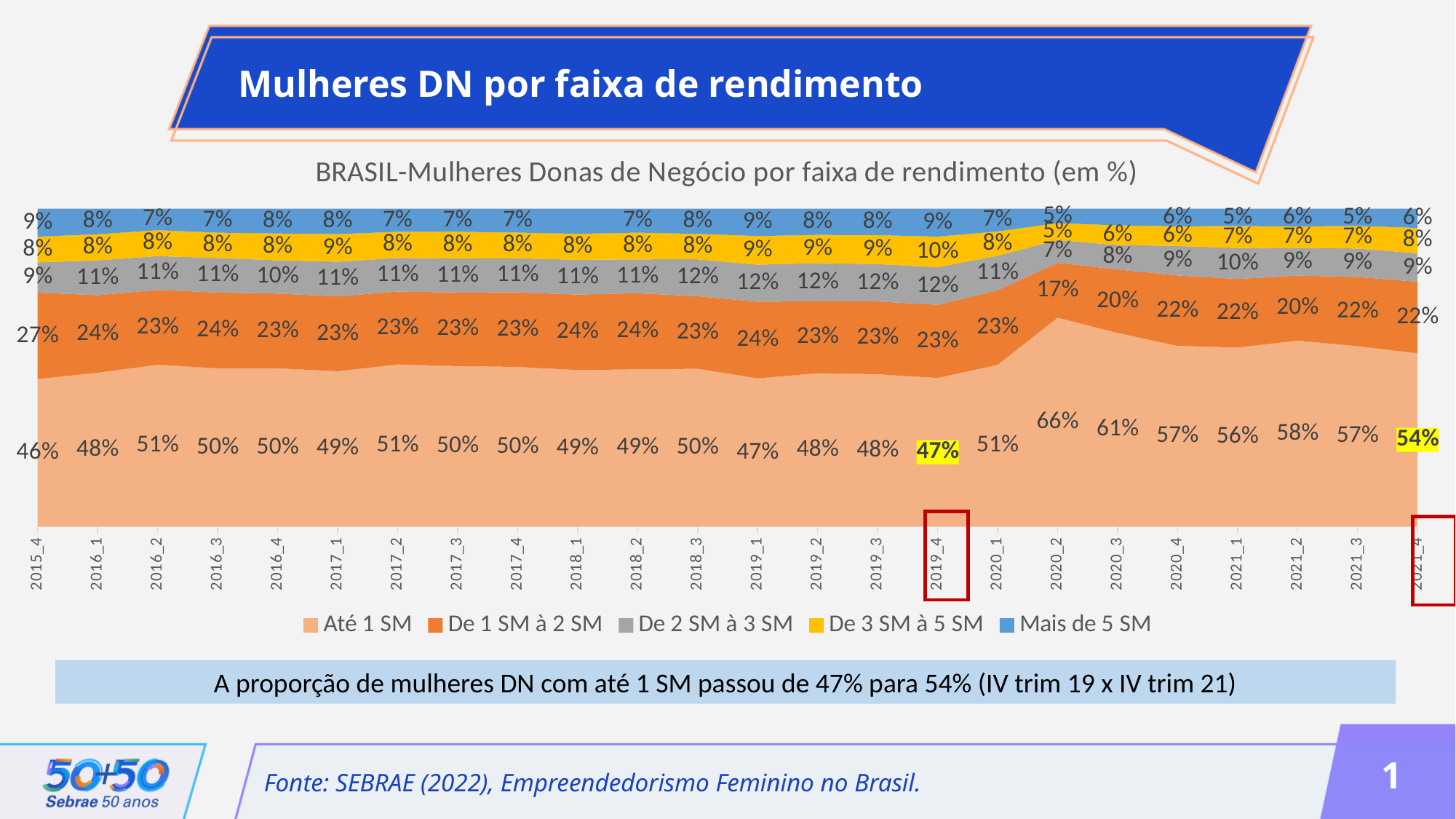
By how many percentage points did 'Até 1 SM' change from 2019_4 to 2021_4? 7 percentage points What is the title of the chart? BRASIL-Mulheres Donas de Negócio por faixa de rendimento (em %) What kind of chart is shown on the slide? Stacked area chart What is the value for 'De 1 SM à 2 SM' in 2020_2? 17% Which is larger in 2020_2: 'De 1 SM à 2 SM' or 'De 2 SM à 3 SM'? De 1 SM à 2 SM What is the value for 'Até 1 SM' in 2021_4? 54% In which quarter does 'Até 1 SM' reach its highest value? 2020_2 What is the value for 'De 3 SM à 5 SM' in 2019_4? 10% In which quarter is 'Até 1 SM' at its lowest value? 2015_4 How many series does the legend list? 5 What is the value for 'Até 1 SM' in 2019_4? 47% How many quarters (categories) are plotted along the x axis? 24